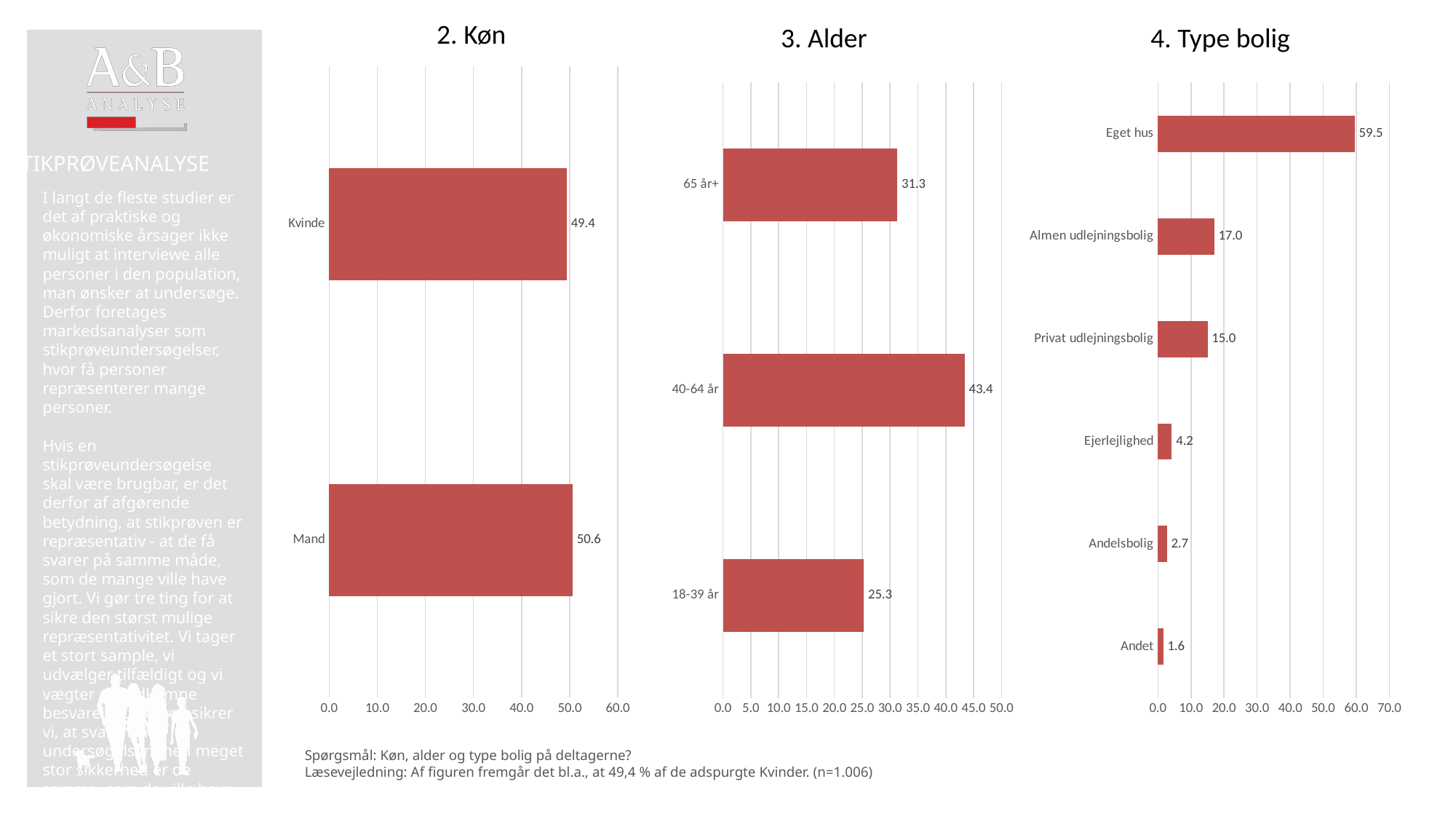
In the "4. Type bolig" chart, what is the value for Andelsbolig? 2.7 In the "3. Alder" chart, what is the value for 40-64 år? 43.4 In the "3. Alder" chart, which age group has the lowest value? 18-39 år In the "2. Køn" chart, which category has the higher value, Kvinde or Mand? Mand In the "4. Type bolig" chart, what is the value for Almen udlejningsbolig? 17.0 In the "2. Køn" chart, what is the value for Kvinde? 49.4 In the "3. Alder" chart, how many age categories are shown? 3 In the "4. Type bolig" chart, how many categories are shown? 6 In the "2. Køn" chart, what is the difference between the values for Mand and Kvinde? 1.2 In the "4. Type bolig" chart, which category has the highest value? Eget hus In the "3. Alder" chart, what is the difference between the values for 65 år+ and 18-39 år? 6.0 What kind of chart is the "4. Type bolig" chart? Bar chart